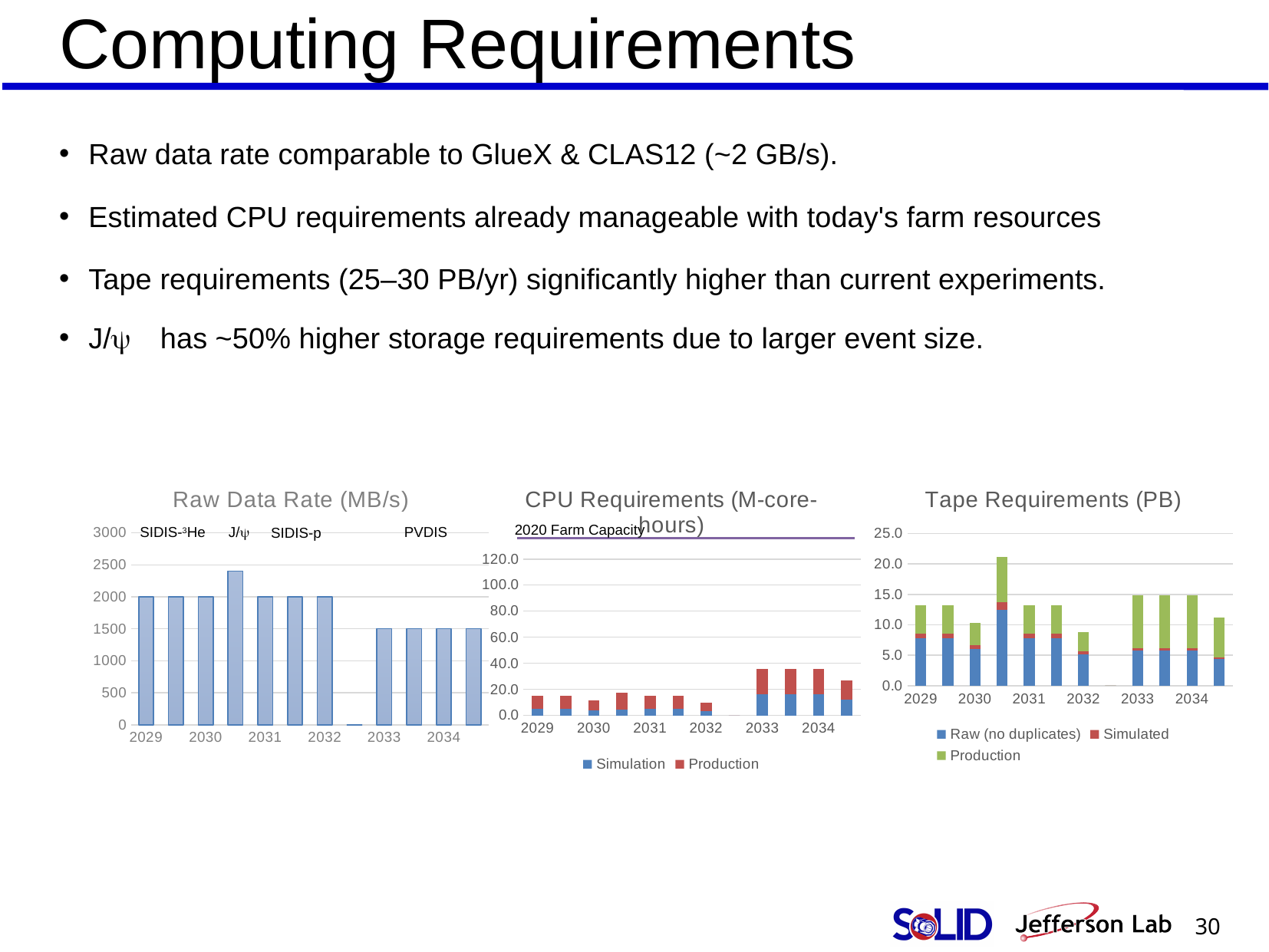
In the "Raw Data Rate (MB/s)" chart, is the value for J/ψ greater or less than 2000? greater In the "Raw Data Rate (MB/s)" chart, are the PVDIS bars greater or less than 2000? less In the "Raw Data Rate (MB/s)" chart, what value do the SIDIS-3He bars reach? 2000 In the "CPU Requirements (M-core-hours)" chart, what is the label of the horizontal line drawn across the top of the plot? 2020 Farm Capacity In the "Tape Requirements (PB)" chart, is the tallest stacked bar greater or less than 15.0? greater What kind of chart is the "Raw Data Rate (MB/s)" chart? bar chart In the "CPU Requirements (M-core-hours)" chart, how many series does the legend list? 2 In the "Tape Requirements (PB)" chart, what are the legend entries? Raw (no duplicates), Simulated, Production In the "Raw Data Rate (MB/s)" chart, which experiment has the highest bar? J/ψ In the "Tape Requirements (PB)" chart, how many series does the legend list? 3